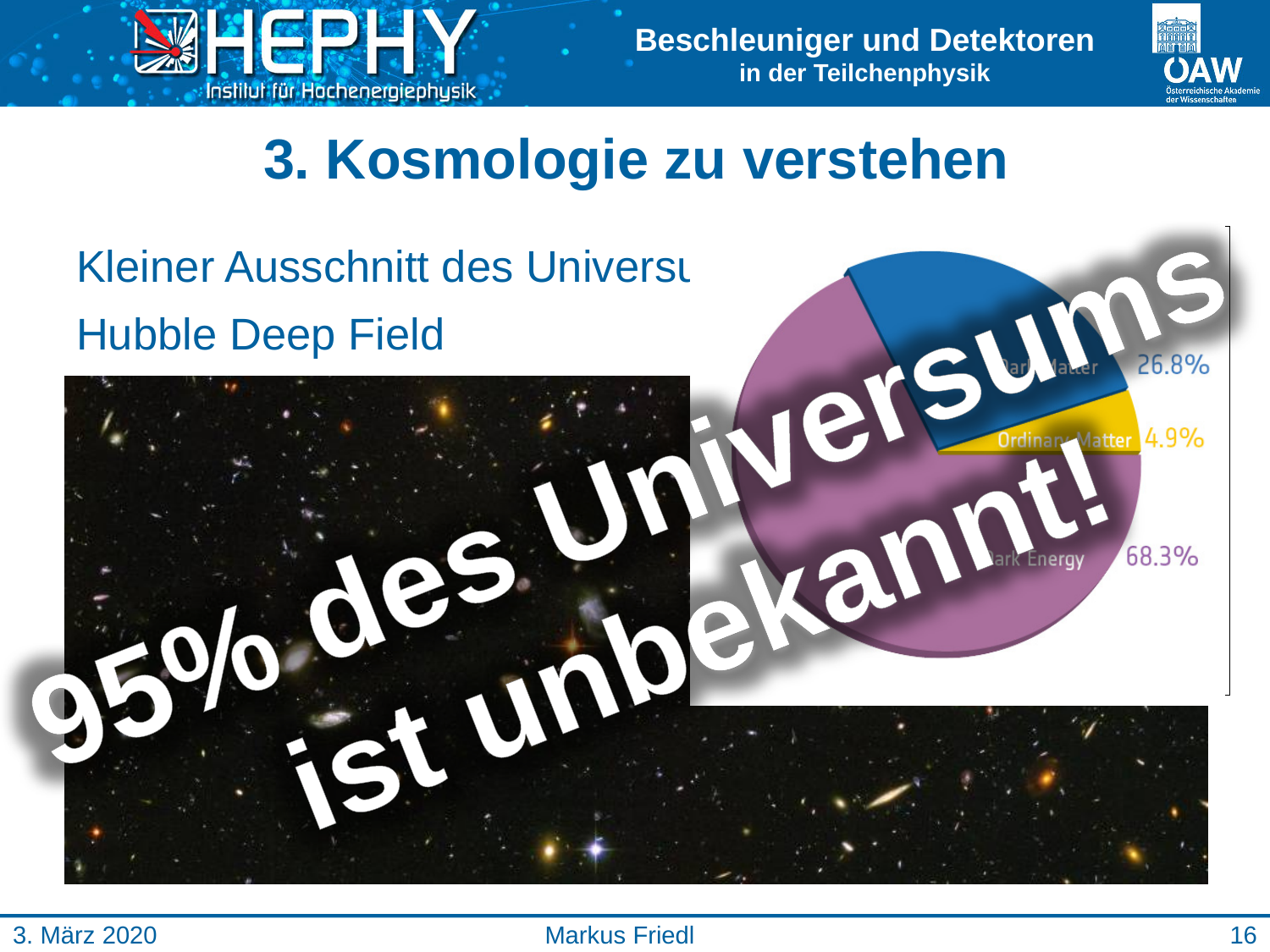
What colour is the Dark Energy slice in the pie chart? purple Which slice of the pie chart is the largest? Dark Energy What is the difference in percentage points between Dark Energy and Dark Matter in the pie chart? 41.5 What percentage does the pie chart give for Dark Matter? 26.8% What colour is the Ordinary Matter slice in the pie chart? yellow How many slices does the pie chart have? 3 What percentage does the pie chart give for Ordinary Matter? 4.9% What is the difference in percentage points between Dark Matter and Ordinary Matter in the pie chart? 21.9 What kind of chart is shown on the slide? pie chart What percentage does the pie chart give for Dark Energy? 68.3% Which slice of the pie chart is the smallest? Ordinary Matter Which is larger in the pie chart, Dark Matter or Ordinary Matter? Dark Matter